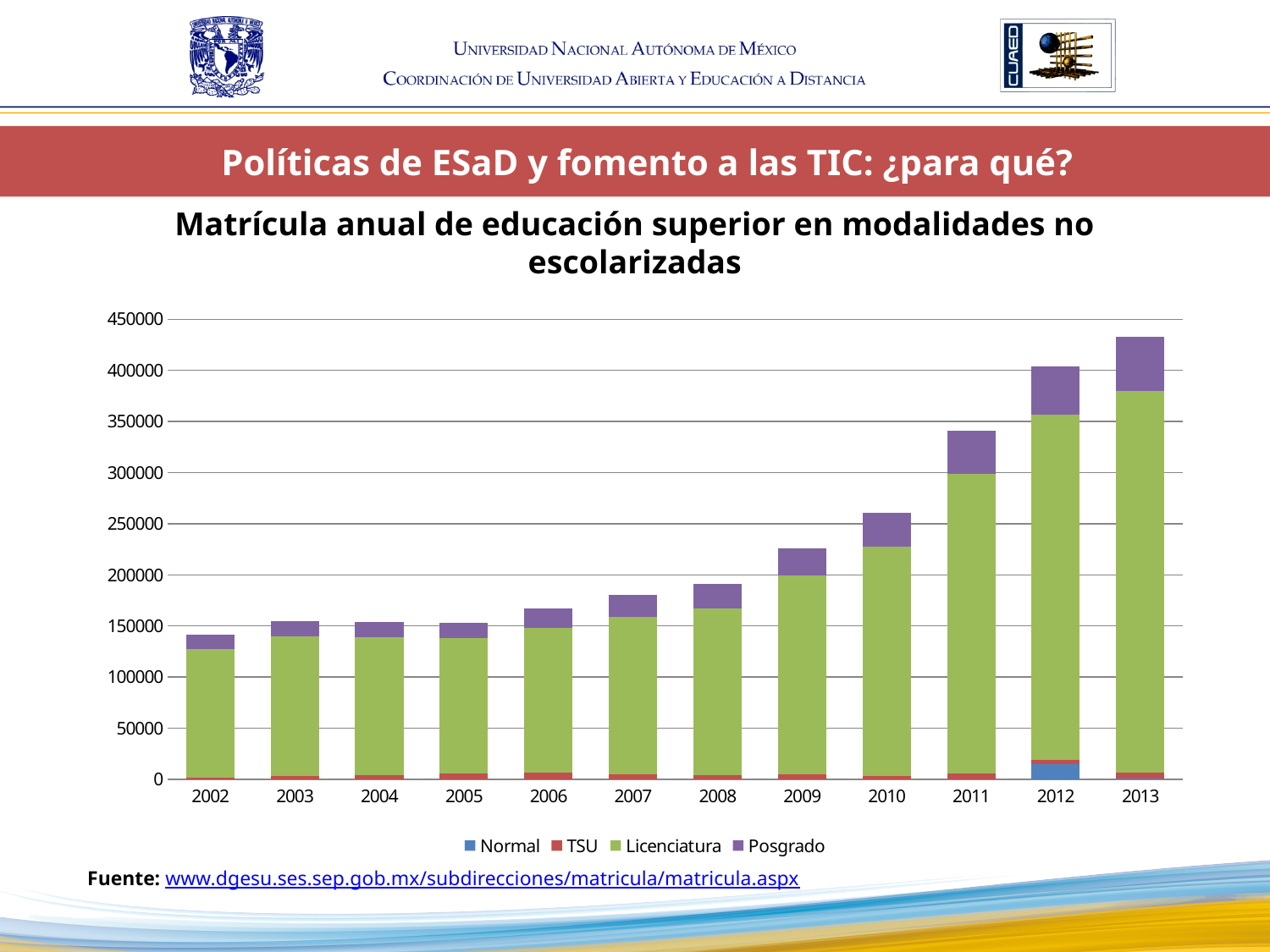
Is the total value for 2013 greater or less than 400000? greater Is the total value for 2002 greater or less than 150000? less Which series is shown in green in the legend? Licenciatura Which year has a larger total, 2009 or 2010? 2010 Which year has the lowest total enrolment? 2002 Is the total value for 2011 greater or less than 350000? less Which year has the highest total enrolment? 2013 What kind of chart is shown on the slide? Stacked bar chart How many series does the legend list? 4 Do the total values rise or fall from 2002 to 2013? Rise How many years are shown on the x axis? 12 What is the title of the chart? Matrícula anual de educación superior en modalidades no escolarizadas